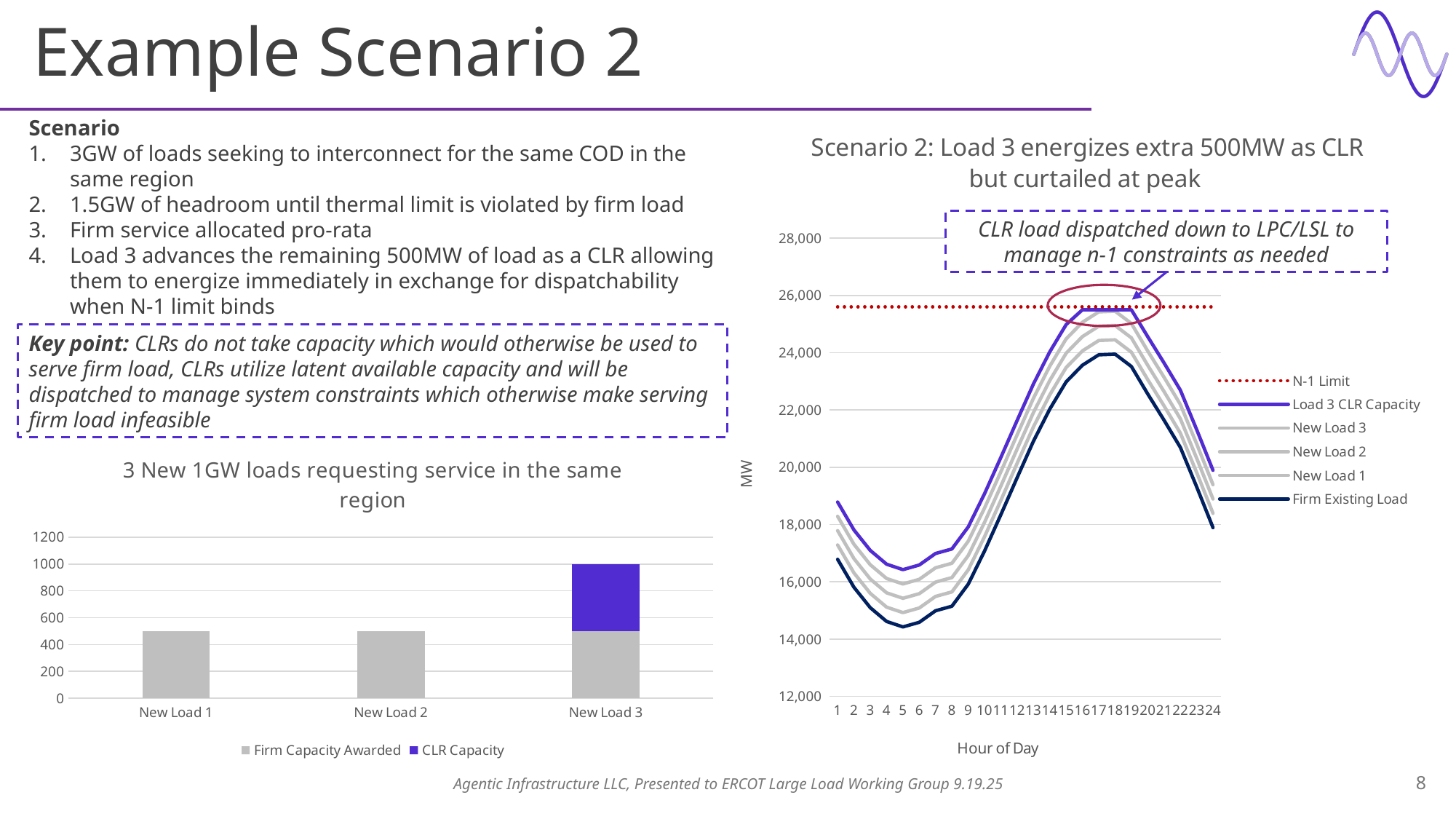
On the chart titled 'Scenario 2: Load 3 energizes extra 500MW as CLR but curtailed at peak', what is the x-axis title? Hour of Day On the chart titled 'Scenario 2: Load 3 energizes extra 500MW as CLR but curtailed at peak', what kind of chart is it? line chart On the chart titled '3 New 1GW loads requesting service in the same region', which category has CLR Capacity plotted? New Load 3 On the chart titled '3 New 1GW loads requesting service in the same region', what is the total height of the stacked bar for New Load 3? 1000 On the chart titled 'Scenario 2: Load 3 energizes extra 500MW as CLR but curtailed at peak', does the Firm Existing Load line rise or fall from hour 1 to hour 5? fall On the chart titled '3 New 1GW loads requesting service in the same region', is the Firm Capacity Awarded value for New Load 1 greater or less than 600? less On the chart titled 'Scenario 2: Load 3 energizes extra 500MW as CLR but curtailed at peak', is the N-1 Limit greater or less than 24,000 MW? greater On the chart titled '3 New 1GW loads requesting service in the same region', what kind of chart is it? bar chart On the chart titled 'Scenario 2: Load 3 energizes extra 500MW as CLR but curtailed at peak', how many series does the legend list? 6 On the chart titled '3 New 1GW loads requesting service in the same region', how many categories are shown on the x axis? 3 On the chart titled '3 New 1GW loads requesting service in the same region', how many series does the legend list? 2 On the chart titled '3 New 1GW loads requesting service in the same region', which category has the tallest bar? New Load 3